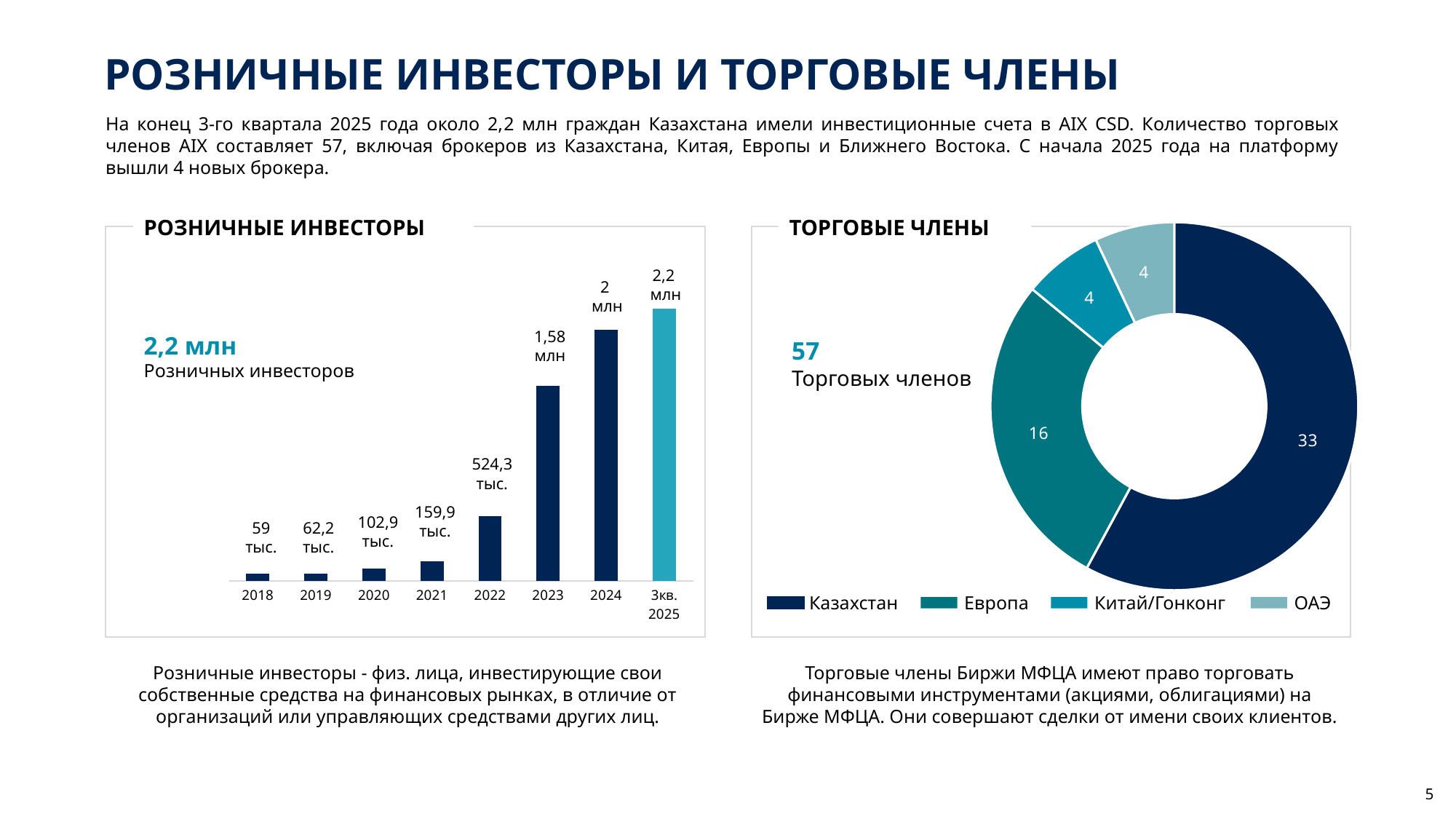
In the 'ТОРГОВЫЕ ЧЛЕНЫ' chart, what is the difference between the values for Казахстан and Европа? 17 In the 'РОЗНИЧНЫЕ ИНВЕСТОРЫ' chart, what is the value for 2022? 524,3 тыс. In the 'РОЗНИЧНЫЕ ИНВЕСТОРЫ' chart, which period has the highest value? 3кв. 2025 What kind of chart is the 'РОЗНИЧНЫЕ ИНВЕСТОРЫ' chart? bar chart In the 'РОЗНИЧНЫЕ ИНВЕСТОРЫ' chart, what is the value for 2023? 1,58 млн In the 'РОЗНИЧНЫЕ ИНВЕСТОРЫ' chart, do the values rise or fall from 2018 to 3кв. 2025? rise In the 'РОЗНИЧНЫЕ ИНВЕСТОРЫ' chart, which year has the lowest value? 2018 In the 'РОЗНИЧНЫЕ ИНВЕСТОРЫ' chart, what is the difference between the values for 2019 and 2018? 3,2 тыс. In the 'ТОРГОВЫЕ ЧЛЕНЫ' chart, what is the value for Европа? 16 How many entries does the legend of the 'ТОРГОВЫЕ ЧЛЕНЫ' chart list? 4 In the 'РОЗНИЧНЫЕ ИНВЕСТОРЫ' chart, how many bars are plotted? 8 In the 'ТОРГОВЫЕ ЧЛЕНЫ' chart, which category has the largest value? Казахстан